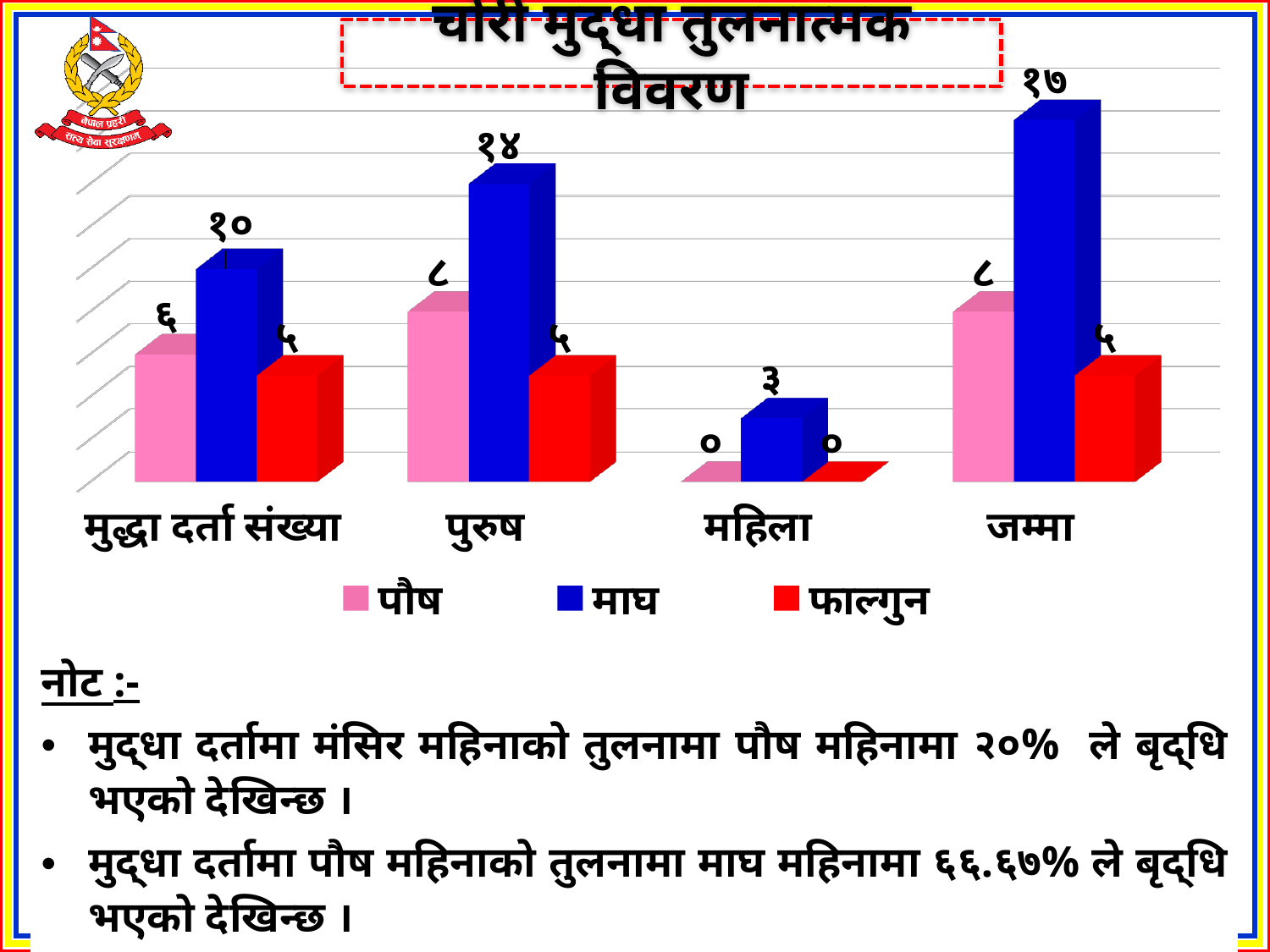
What is the value of the माघ series for the महिला category? ३ How many categories are shown on the x axis of the chart? 4 What is the difference between the माघ and पौष values for the जम्मा category? ९ What kind of chart is shown on the slide? Bar chart Which colour represents the माघ series in the chart? Blue How many series does the chart legend list? 3 What is the value of the फाल्गुन series for the जम्मा category? ५ For the मुद्दा दर्ता संख्या category, which series has the larger value, पौष or फाल्गुन? पौष Which category has the highest value in the माघ series? जम्मा What is the value of the माघ series for the पुरुष category? १४ What is the value of the पौष series for the मुद्दा दर्ता संख्या category? ६ Which category has the lowest value in the पौष series? महिला